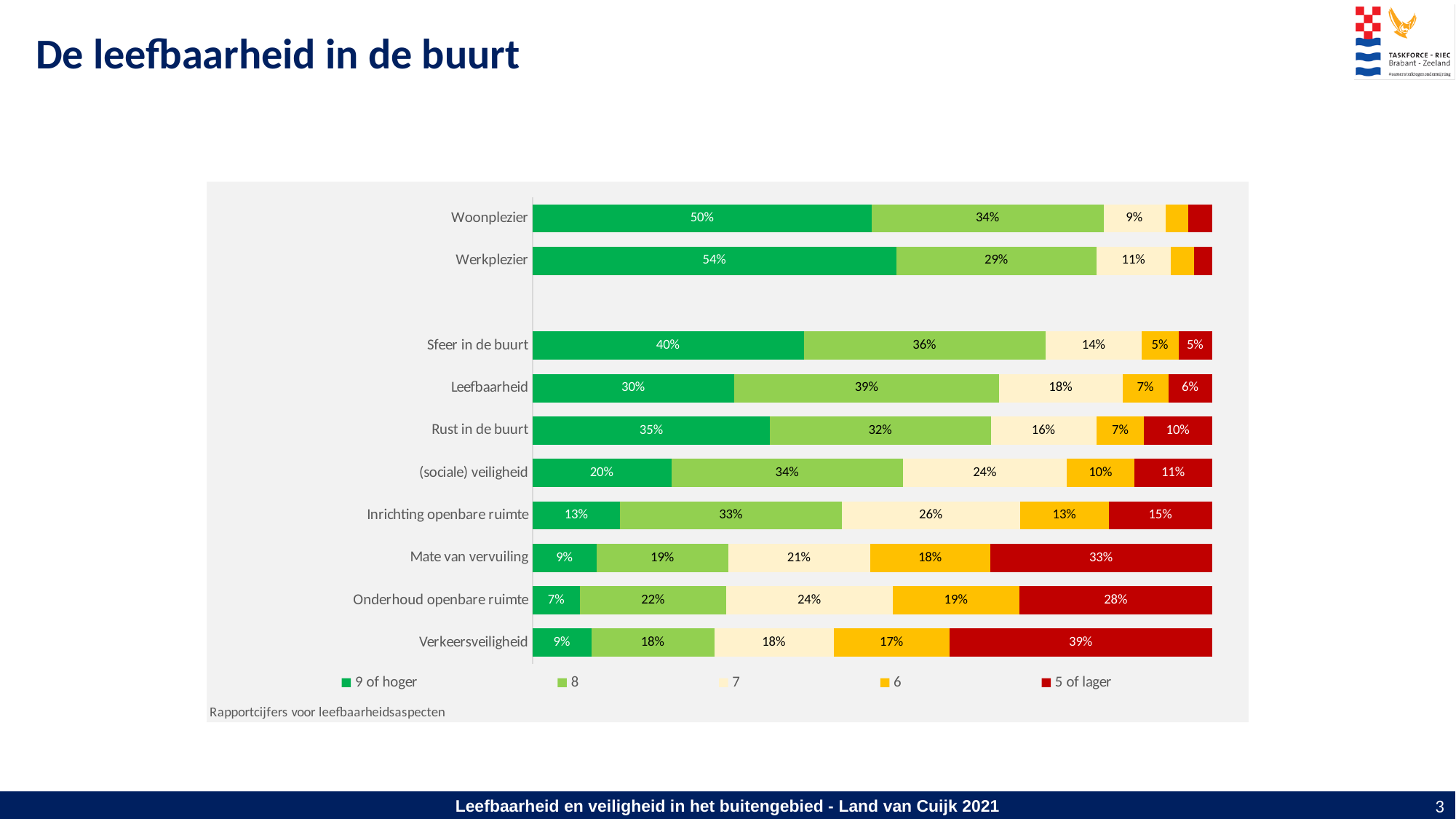
What type of chart is shown on the slide? Stacked bar chart Which category has the highest '9 of hoger' percentage? Werkplezier What is the value of the '5 of lager' segment for Verkeersveiligheid? 39% Which has a larger '9 of hoger' share: Rust in de buurt or Sfeer in de buurt? Sfeer in de buurt What percentage gave Leefbaarheid a score of 8? 39% What percentage of respondents gave Werkplezier a score of 9 of hoger? 54% Which category has the lowest '9 of hoger' percentage? Onderhoud openbare ruimte What is the value of the '7' segment for (sociale) veiligheid? 24% What is the difference in percentage points between the '9 of hoger' values for Sfeer in de buurt and Leefbaarheid? 10 How many categories (aspects) are shown in the chart? 10 Which category has the largest '5 of lager' share? Verkeersveiligheid How many series does the legend list? 5